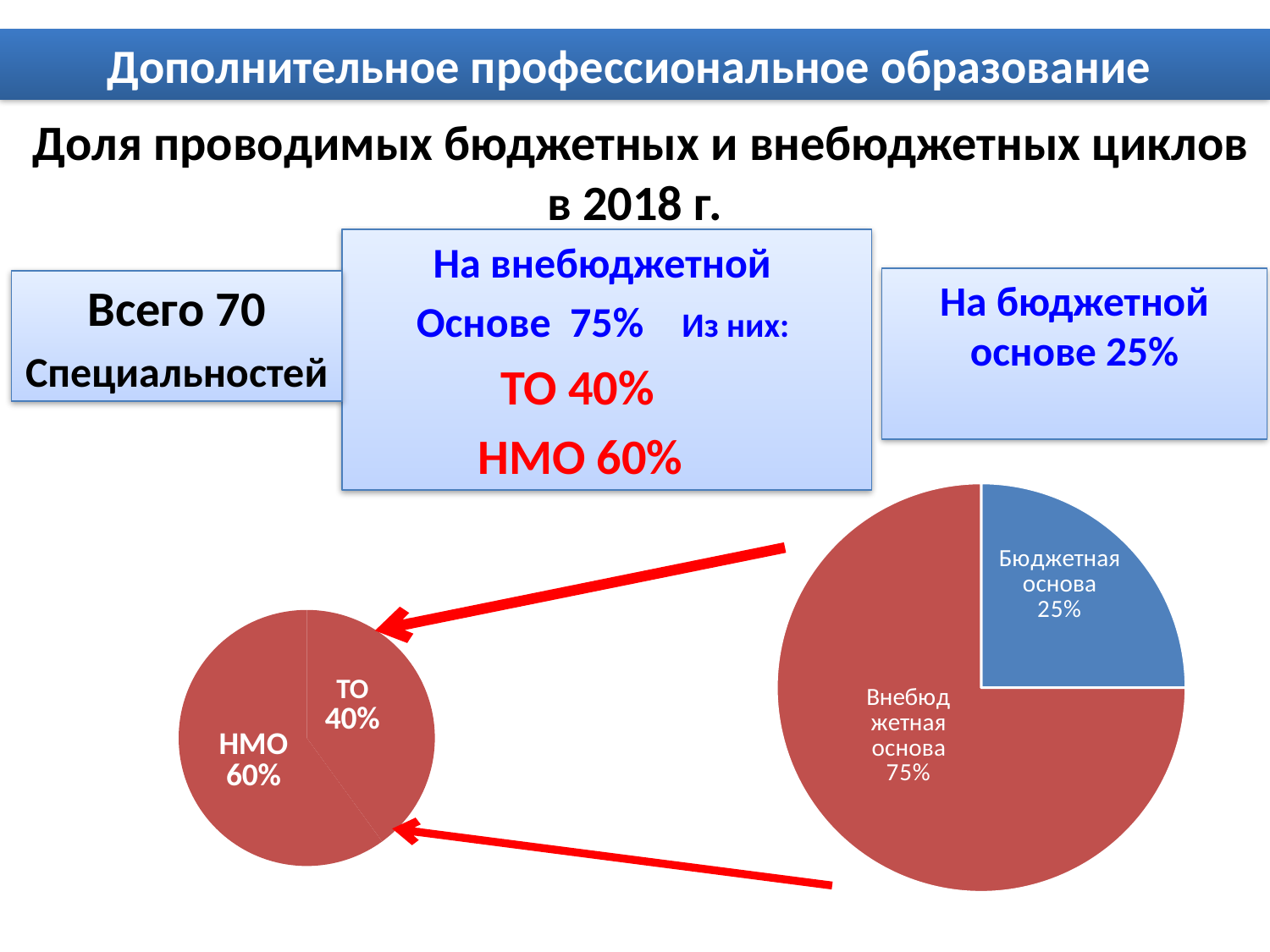
What kind of chart is the large chart on the right of the slide? pie chart In the pie chart on the right, what is the difference between the Внебюджетная основа share and the Бюджетная основа share? 50% In the pie chart on the right, what colour is the Бюджетная основа slice? blue In the small pie chart on the left, what share is labelled for ТО? 40% In the small pie chart on the left, what is the difference between the НМО share and the ТО share? 20% In the pie chart on the right, what share is labelled for Внебюджетная основа? 75% How many slices does the pie chart on the right have? 2 In the pie chart on the right, what share is labelled for Бюджетная основа? 25% In the small pie chart on the left, which slice is the largest? НМО In the pie chart on the right, which slice is larger: Бюджетная основа or Внебюджетная основа? Внебюджетная основа What kind of chart is the small chart on the left of the slide? pie chart